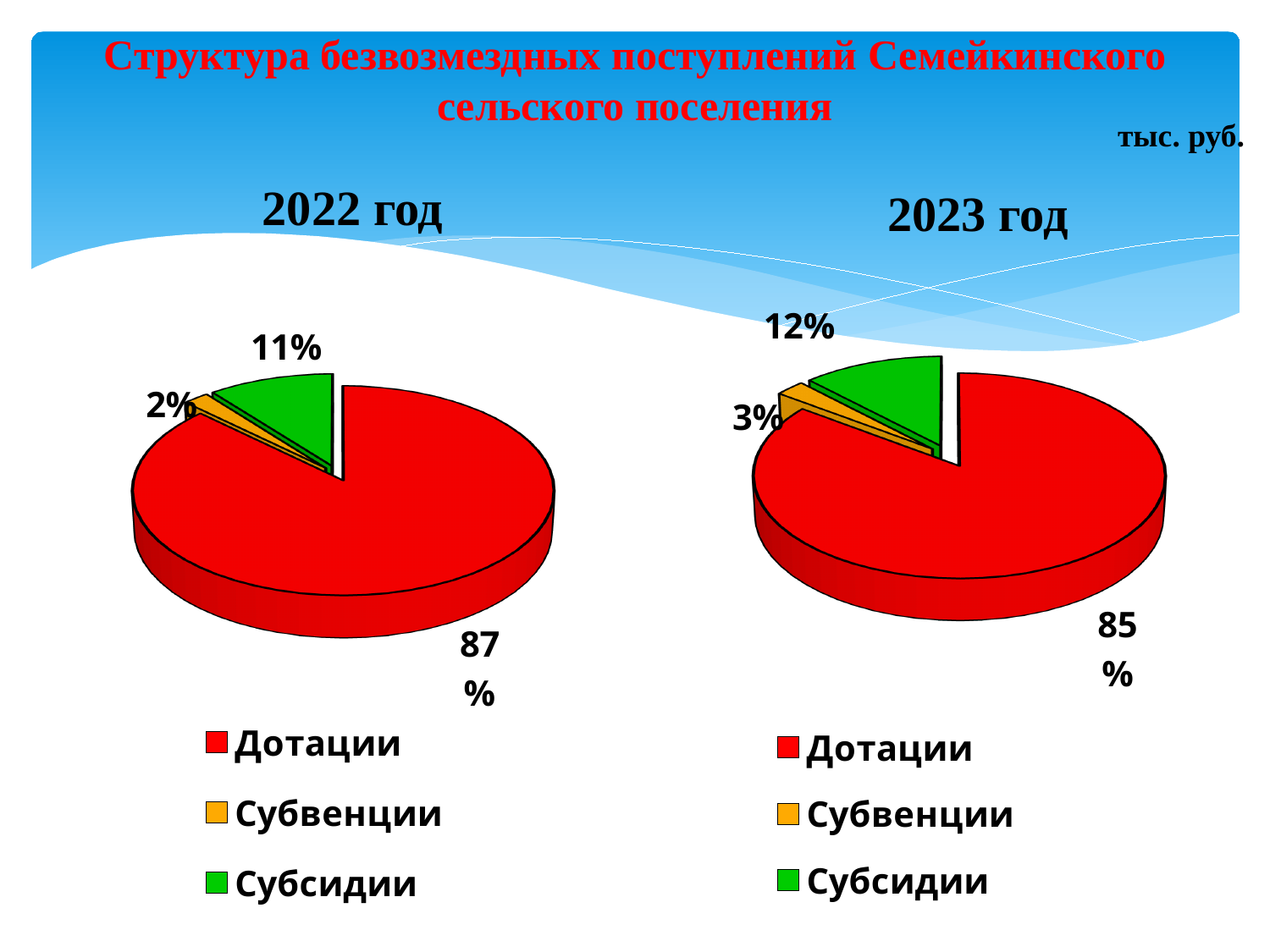
In the 2023 год chart, what colour represents Субвенции in the legend? Orange How many slices does the 2023 год pie chart have? 3 In the 2023 год pie chart, what share is labelled for Субвенции? 3% In the 2022 год pie chart, what share is labelled for Субвенции? 2% In the 2023 год pie chart, which category has the smallest slice? Субвенции In the 2022 год pie chart, what is the difference in percentage points between Дотации and Субсидии? 76 What type of chart is used for 2022 год? Pie chart In the 2023 год pie chart, what share is labelled for Субсидии? 12% How many entries does the legend of the 2022 год chart list? 3 In the 2022 год pie chart, which category has the largest slice? Дотации In the 2022 год pie chart, what share is labelled for Дотации? 87% Which is larger: the Субсидии share in the 2022 год chart or in the 2023 год chart? 2023 год